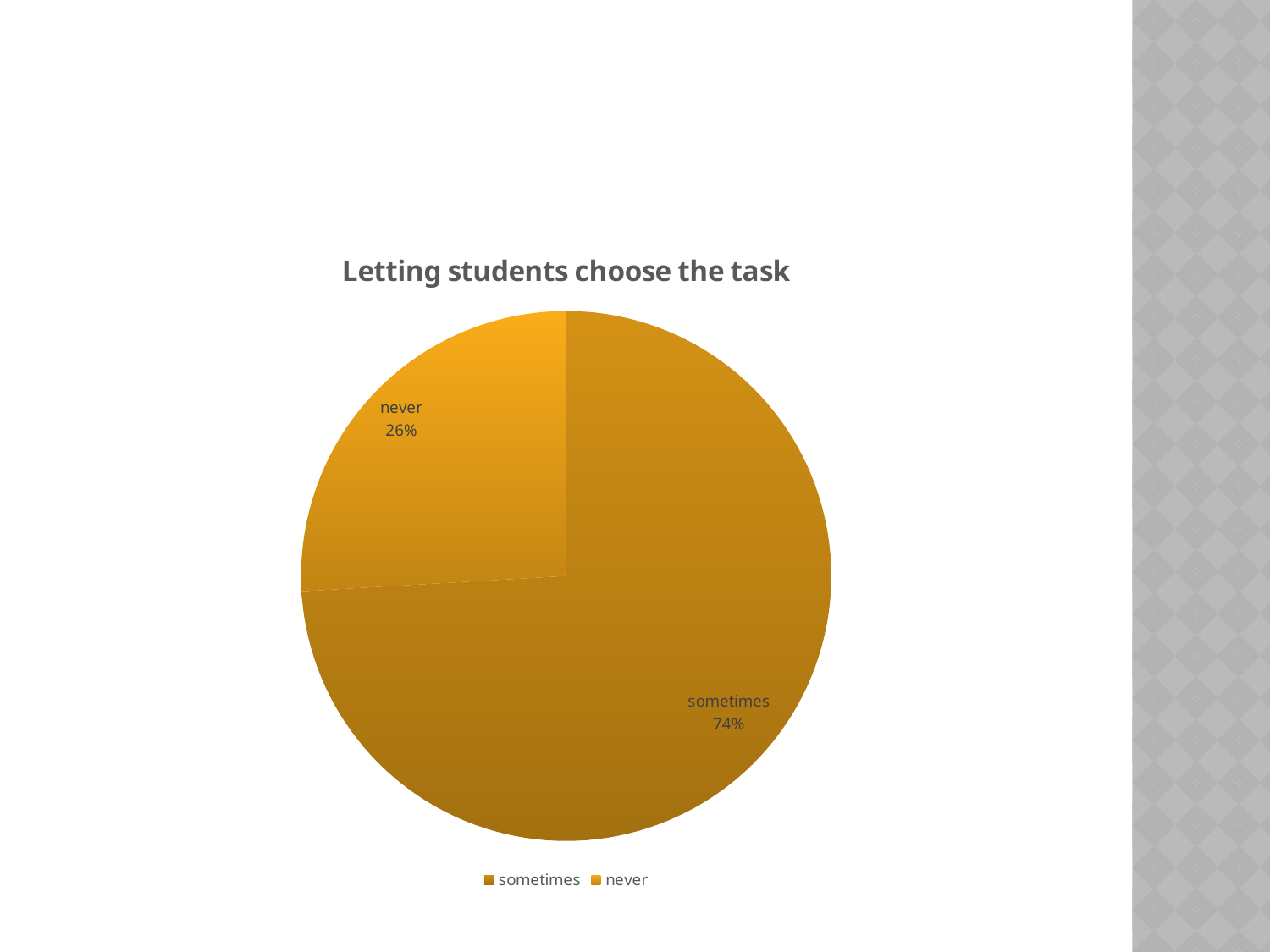
Which entries appear in the legend, in order? sometimes, never How many entries does the legend list? 2 What kind of chart is shown on the slide? pie chart What is the title of the chart? Letting students choose the task What share of the pie does "sometimes" take? 74% Which is larger, the slice for "sometimes" or the slice for "never"? sometimes How many slices does the pie chart have? 2 What share of the pie does "never" take? 26% What is the difference in percentage points between "sometimes" and "never"? 48 Which category has the largest slice? sometimes Is the share for "never" greater or less than 50%? less Which category has the smallest slice? never